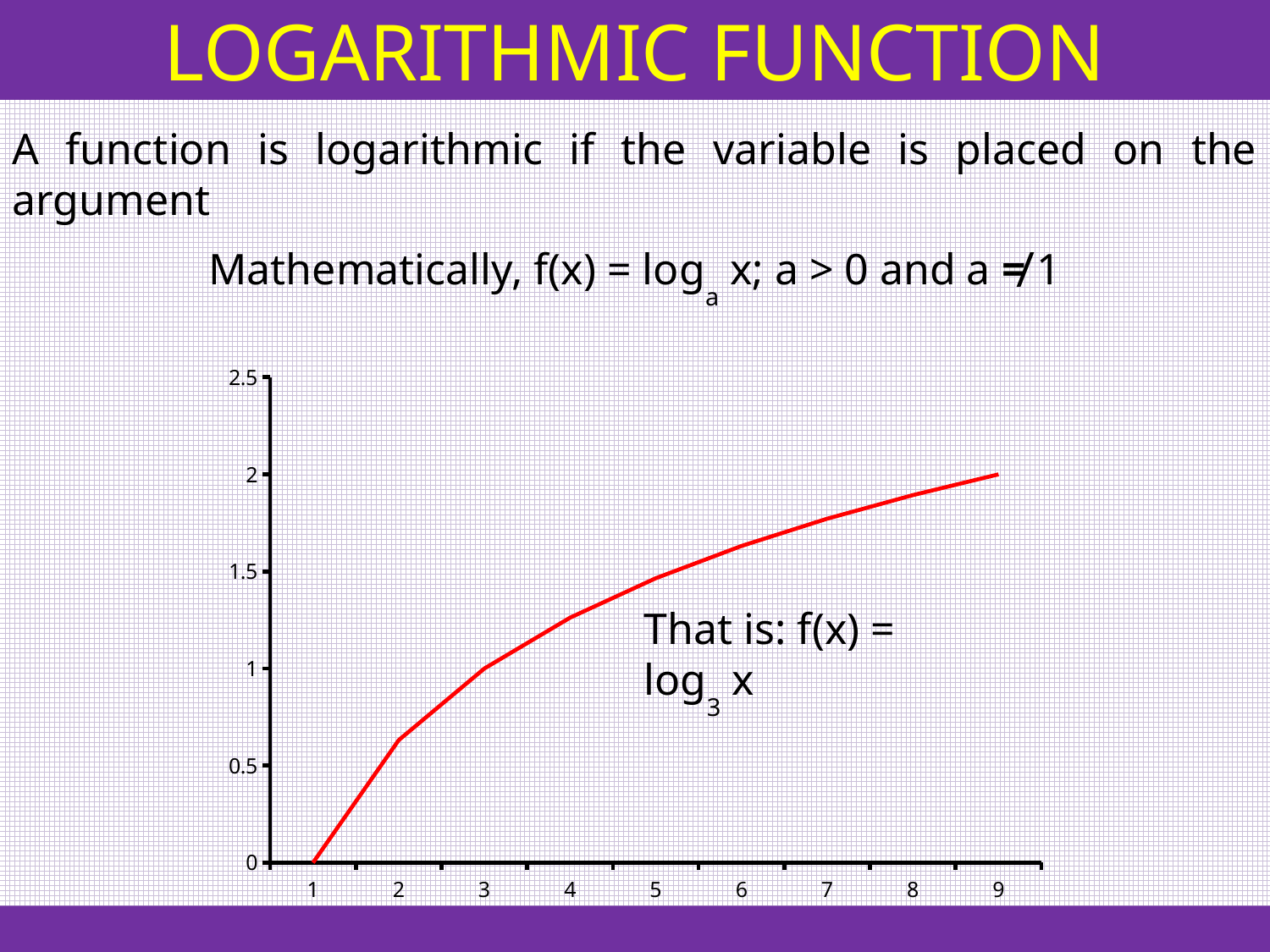
What is the value of f(x) at x = 3 on the chart? 1 At which labelled x value does the curve reach its highest point? 9 What is the value of f(x) at x = 9 on the chart? 2 Is the value of f(x) at x = 2 greater or less than 1? less What kind of chart is shown on the slide? line chart Do the values of the plotted curve rise or fall as x increases from 1 to 9? rise What is the value of f(x) at x = 1 on the chart? 0 Is the value of f(x) at x = 8 greater or less than 2? less Which function does the chart's annotation say is plotted? f(x) = log₃ x Is the value of f(x) at x = 2 greater or less than 0.5? greater How many labelled tick values are shown on the x axis? 9